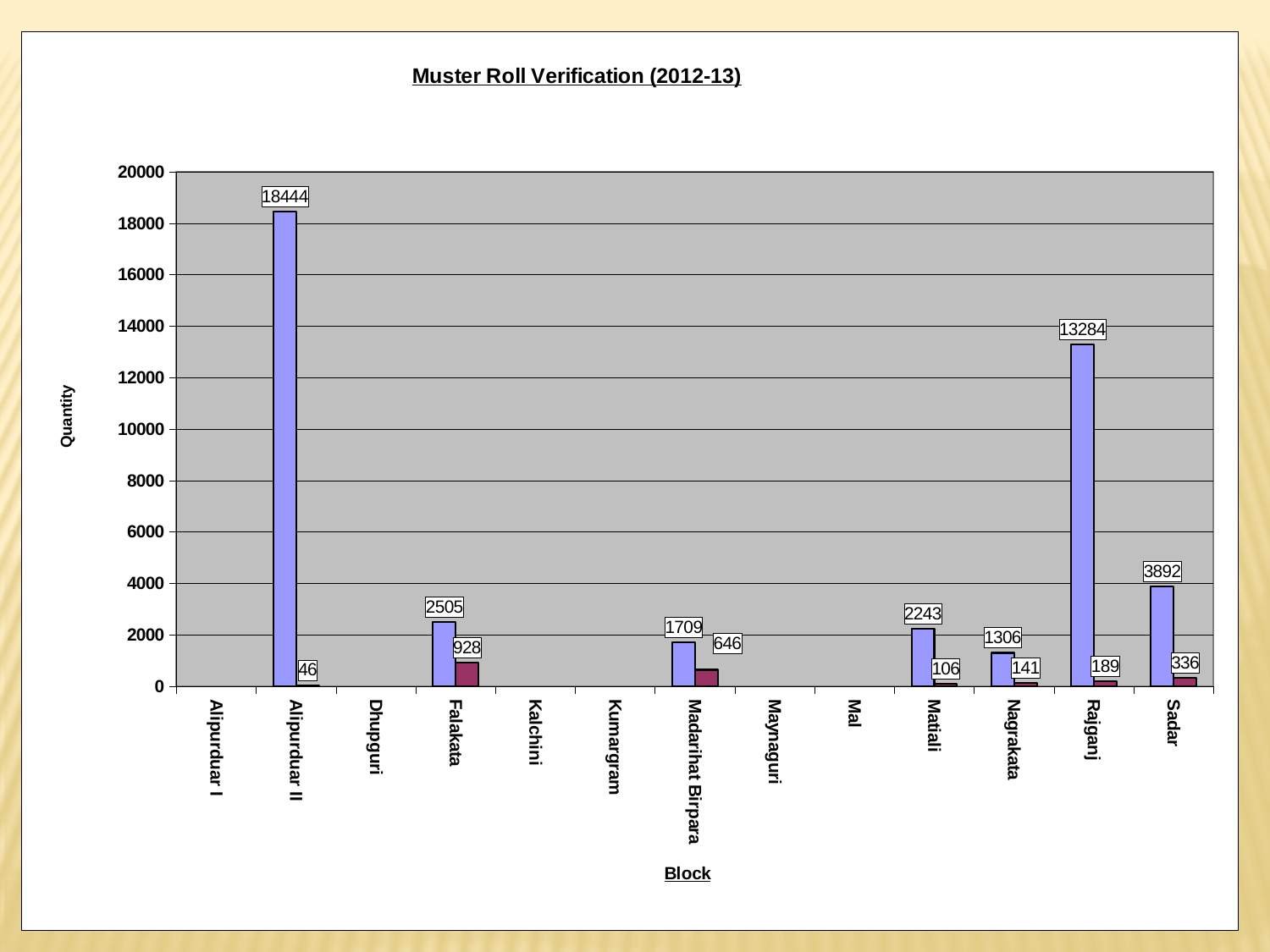
What is the value of the blue bar for Rajganj? 13284 What type of chart is shown on the slide? bar chart What is the value of the blue bar for Alipurduar II? 18444 Which block has the highest blue bar? Alipurduar II What is the difference between the blue bar values for Alipurduar II and Rajganj? 5160 How many blocks are listed along the x axis of the chart? 13 Which is larger, the blue bar for Sadar or the blue bar for Falakata? Sadar Which block has the highest maroon bar? Falakata What is the label of the y axis? Quantity What is the title of the chart? Muster Roll Verification (2012-13) What is the difference between the blue and maroon bar values for Madarihat Birpara? 1063 What is the value of the maroon bar for Falakata? 928